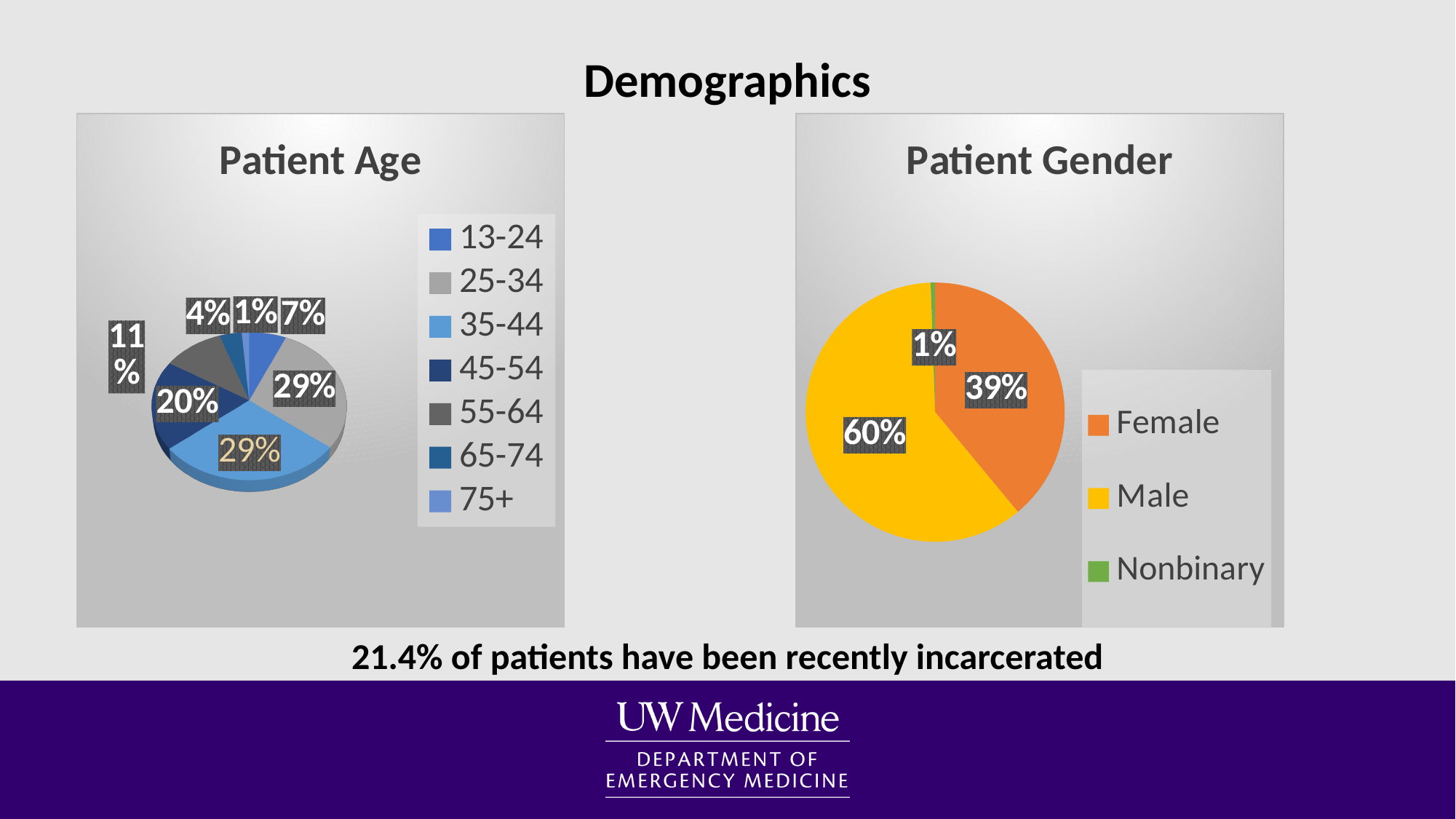
In the Patient Age chart, which has the larger share: 45-54 or 55-64? 45-54 In the Patient Gender chart, what is the difference between the Male and Female shares? 21% In the Patient Age chart, what share of patients are aged 45-54? 20% How many age groups are shown in the Patient Age chart? 7 How many categories does the legend of the Patient Gender chart list? 3 In the Patient Age chart, which age group has the smallest share? 75+ In the Patient Age chart, what share of patients are aged 13-24? 7% In the Patient Gender chart, which gender category has the largest share? Male In the Patient Gender chart, what share of patients are Female? 39% What kind of chart is the Patient Gender chart? pie chart